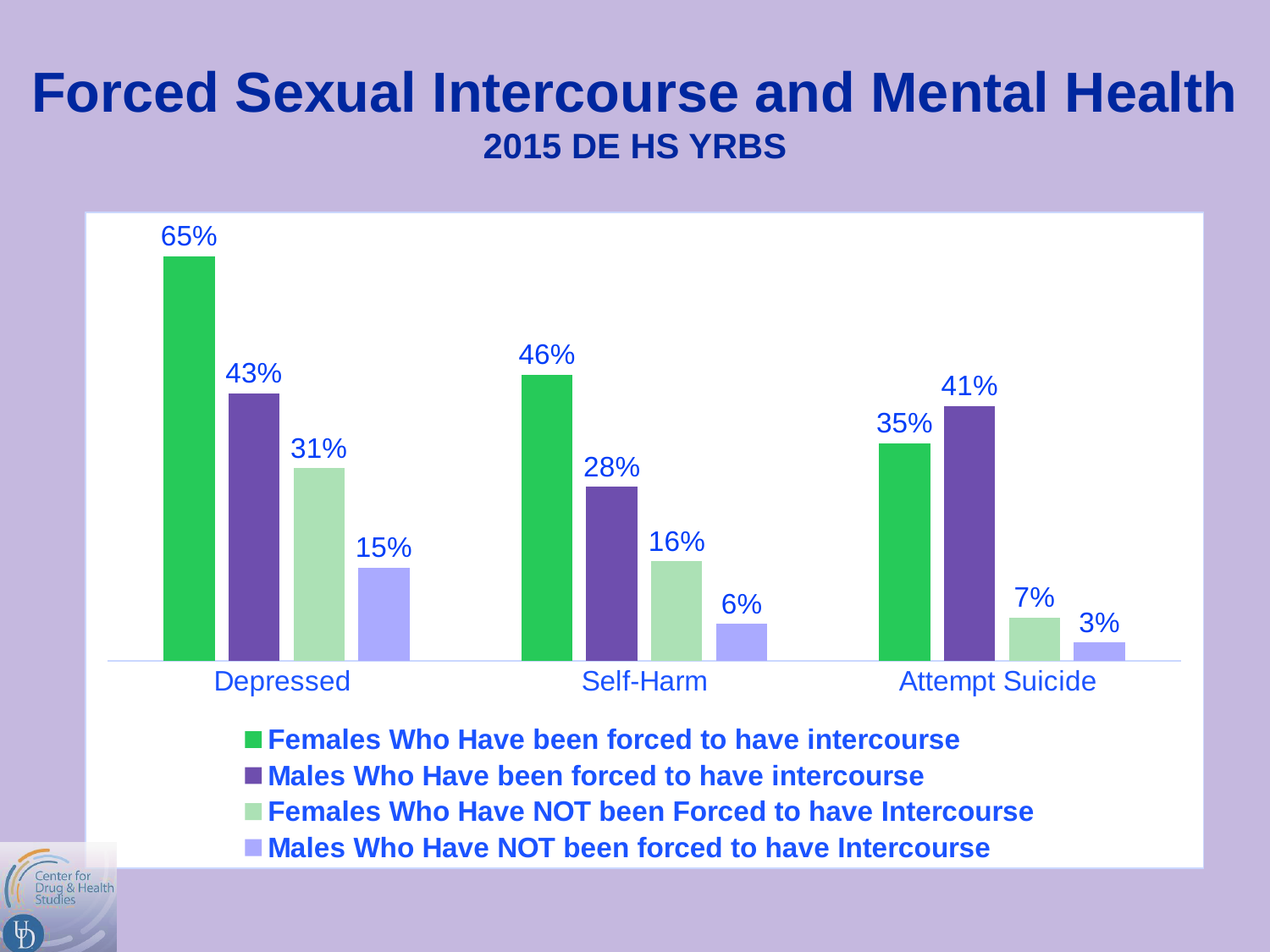
What is the difference between females who have been forced and females who have NOT been forced to have intercourse in the Depressed category? 34% Which category has the highest value for females who have been forced to have intercourse? Depressed Do the values for females who have NOT been forced to have intercourse rise or fall from Depressed to Attempt Suicide? Fall What kind of chart is shown on the slide? Bar chart What is the value for males who have NOT been forced to have intercourse in the Attempt Suicide category? 3% What is the subtitle shown under the chart title? 2015 DE HS YRBS In the Attempt Suicide category, which is larger: the value for females who have been forced or males who have been forced to have intercourse? Males Who Have been forced to have intercourse What percentage of females who have been forced to have intercourse reported being depressed? 65% Which category has the lowest value for males who have NOT been forced to have intercourse? Attempt Suicide How many series does the legend list? 4 What percentage of males who have been forced to have intercourse reported self-harm? 28% How many categories are shown on the x axis? 3